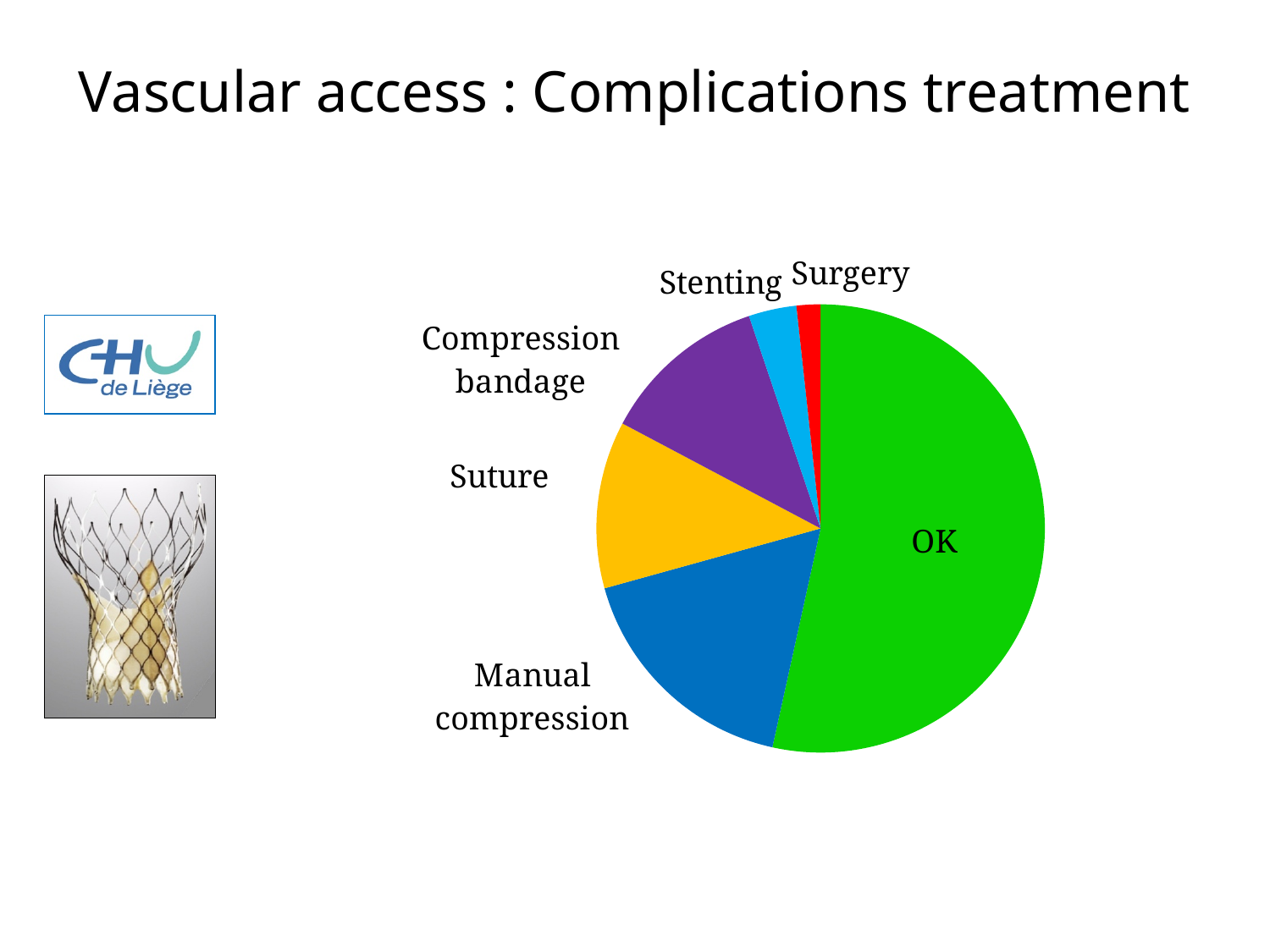
How many slices does the pie chart have? 6 Which category has the smallest slice of the pie chart? Surgery Which slice is larger, Stenting or Compression bandage? Compression bandage What colour is the OK slice of the pie chart? Green What is the title of the slide containing the pie chart? Vascular access : Complications treatment Which slice is larger, Surgery or Stenting? Stenting Which category has the largest slice of the pie chart? OK What kind of chart is shown on the slide? Pie chart Which slice is larger, Manual compression or Suture? Manual compression